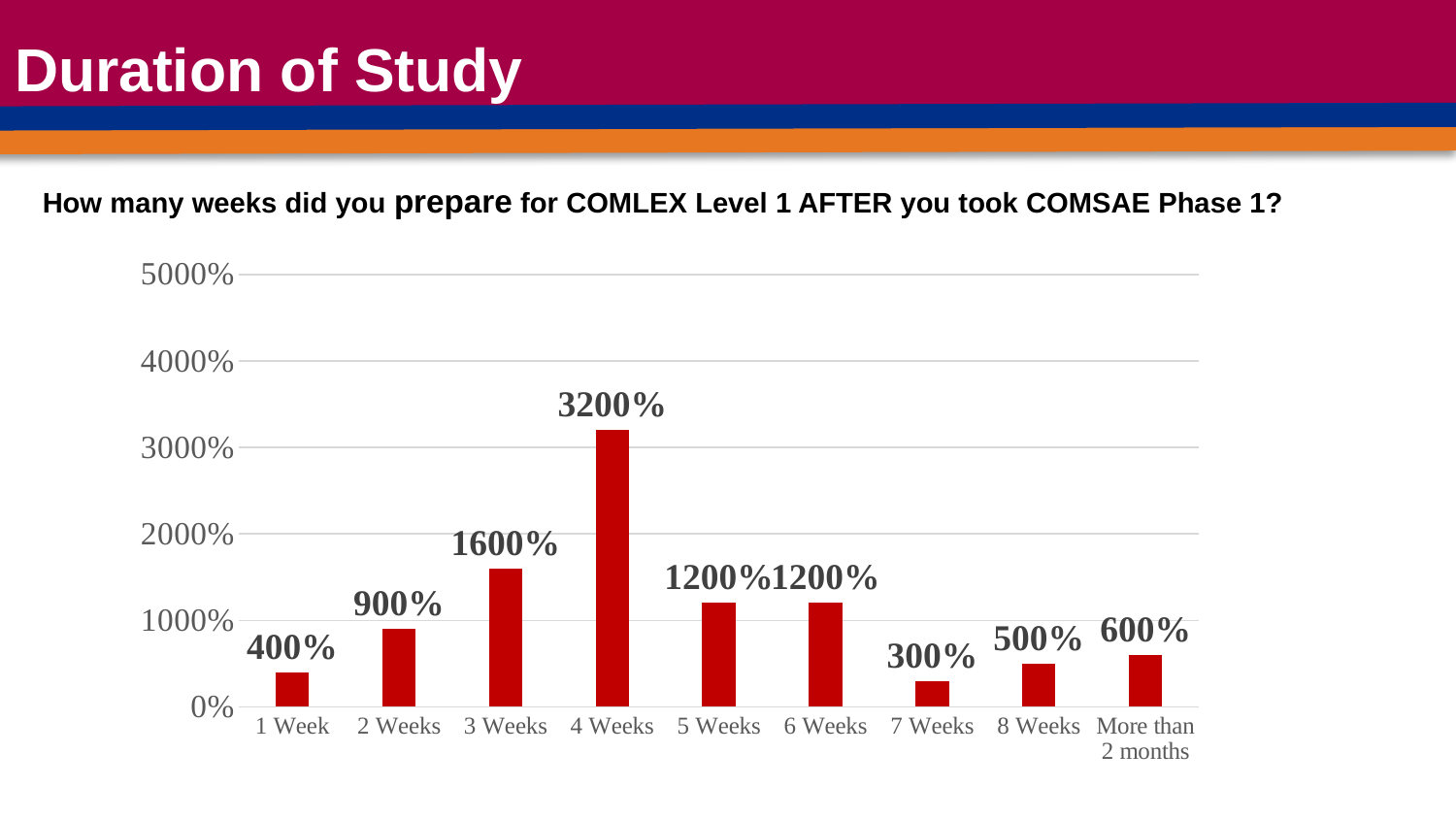
How many categories are shown on the x axis? 9 What is the value for 4 Weeks? 3200% What is the value for More than 2 months? 600% Which is larger, the value for 2 Weeks or the value for 8 Weeks? 2 Weeks What is the value for 1 Week? 400% Which category has the lowest value? 7 Weeks What kind of chart is shown on the slide? bar chart Which category has the highest value? 4 Weeks What is the difference between the values for 4 Weeks and 3 Weeks? 1600% What is the value for 5 Weeks? 1200% Is the value for 3 Weeks greater or less than 2000%? less Do the values rise or fall from 4 Weeks to 7 Weeks? fall